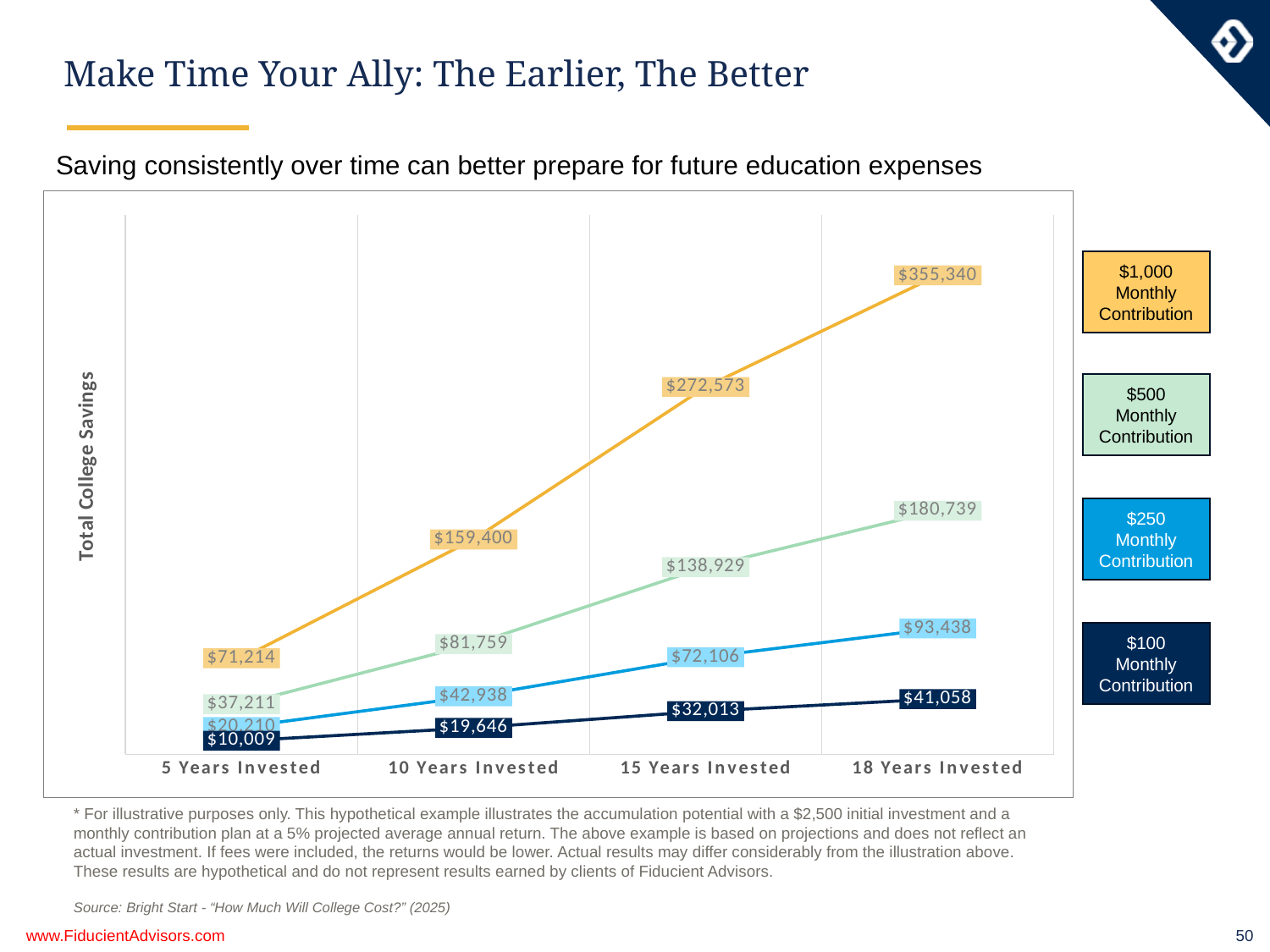
What is the total college savings for the $500 Monthly Contribution series at 10 Years Invested? $81,759 Do the values for the $250 Monthly Contribution series rise or fall as years invested increase? Rise How many time periods are shown on the x axis? 4 How many series does the legend list? 4 Which is larger: the $500 Monthly Contribution value at 15 Years Invested or the $1,000 Monthly Contribution value at 10 Years Invested? The $1,000 Monthly Contribution value at 10 Years Invested ($159,400) Which series has the highest value at 18 Years Invested? $1,000 Monthly Contribution What is the total college savings for the $100 Monthly Contribution series at 5 Years Invested? $10,009 What type of chart is shown on the slide? Line chart What is the total college savings for the $1,000 Monthly Contribution series at 18 Years Invested? $355,340 What is the total college savings for the $250 Monthly Contribution series at 15 Years Invested? $72,106 Which series has the lowest value at 10 Years Invested? $100 Monthly Contribution What is the difference between the $1,000 Monthly Contribution value and the $500 Monthly Contribution value at 18 Years Invested? $174,601